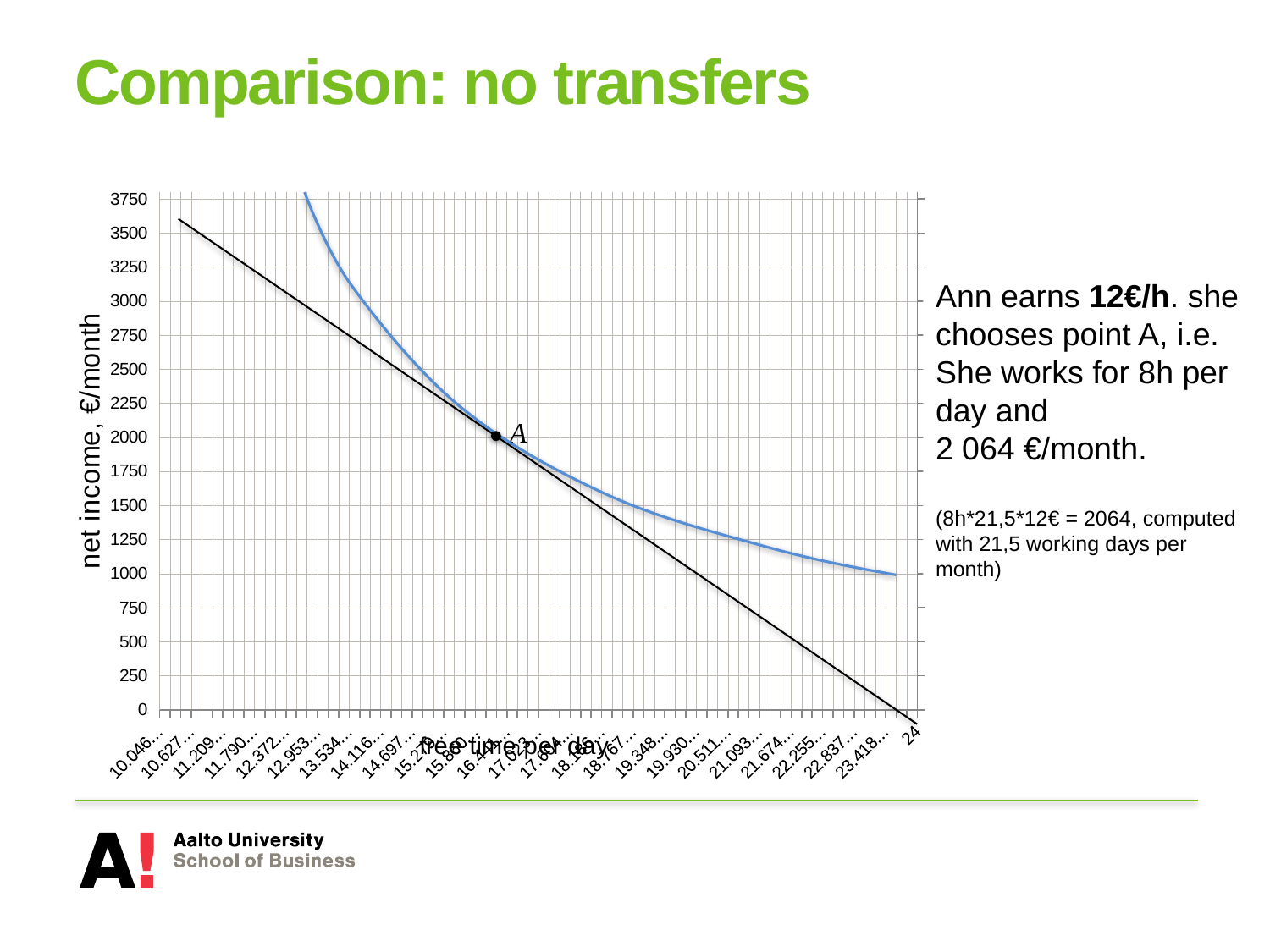
Is the net income of the black line at its left end greater or less than 3250? greater What is the last value shown on the horizontal axis of the chart? 24 What kind of chart is shown on the slide? line chart What is the label of the horizontal axis of the chart? free time per day Does the black straight line rise or fall as free time per day increases? fall How many curves or lines are plotted on the chart? 2 What is the label of the vertical axis of the chart? net income, €/month What is the highest value shown on the vertical axis of the chart? 3750 Is the net income at point A greater or less than 1500? greater Does the blue curve rise or fall as free time per day increases? fall According to the slide text, what net income per month does Ann have at point A? 2 064 €/month Is the net income at point A greater or less than 2500? less